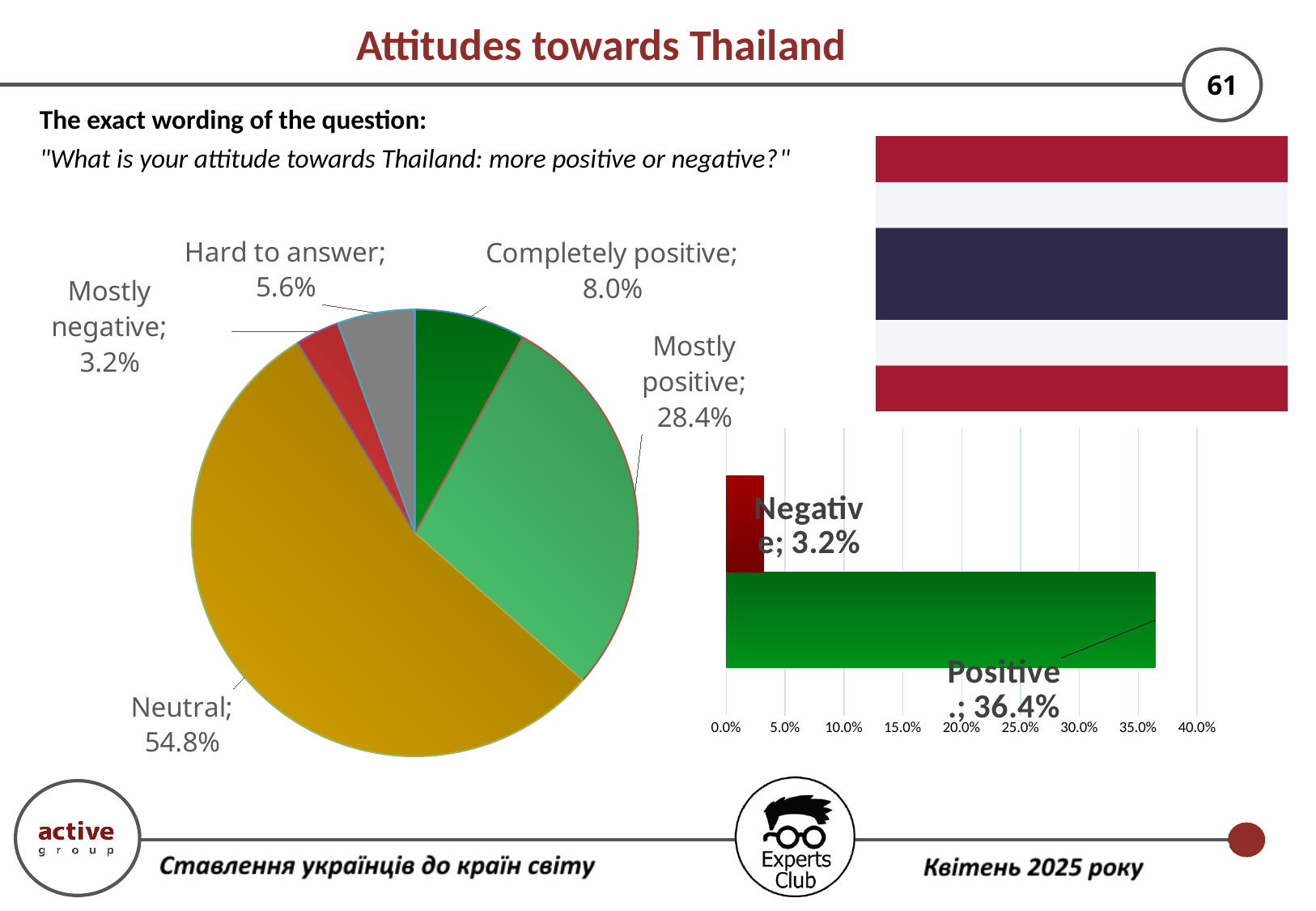
In the pie chart, what share of respondents answered "Neutral"? 54.8% In the pie chart, which category has the smallest share? Mostly negative In the pie chart, which category has the largest share? Neutral In the pie chart, what share of respondents answered "Mostly positive"? 28.4% In the pie chart, what share of respondents answered "Completely positive"? 8.0% In the bar chart on the right, what is the value for "Positive"? 36.4% In the bar chart on the right, what is the value for "Negative"? 3.2% What type of chart is shown on the right side of the slide? Bar chart In the bar chart on the right, what is the difference between the "Positive" and "Negative" values? 33.2% In the pie chart, how many categories are shown? 5 In the pie chart, what share of respondents answered "Hard to answer"? 5.6% In the pie chart, what is the difference between the "Mostly positive" and "Completely positive" shares? 20.4%